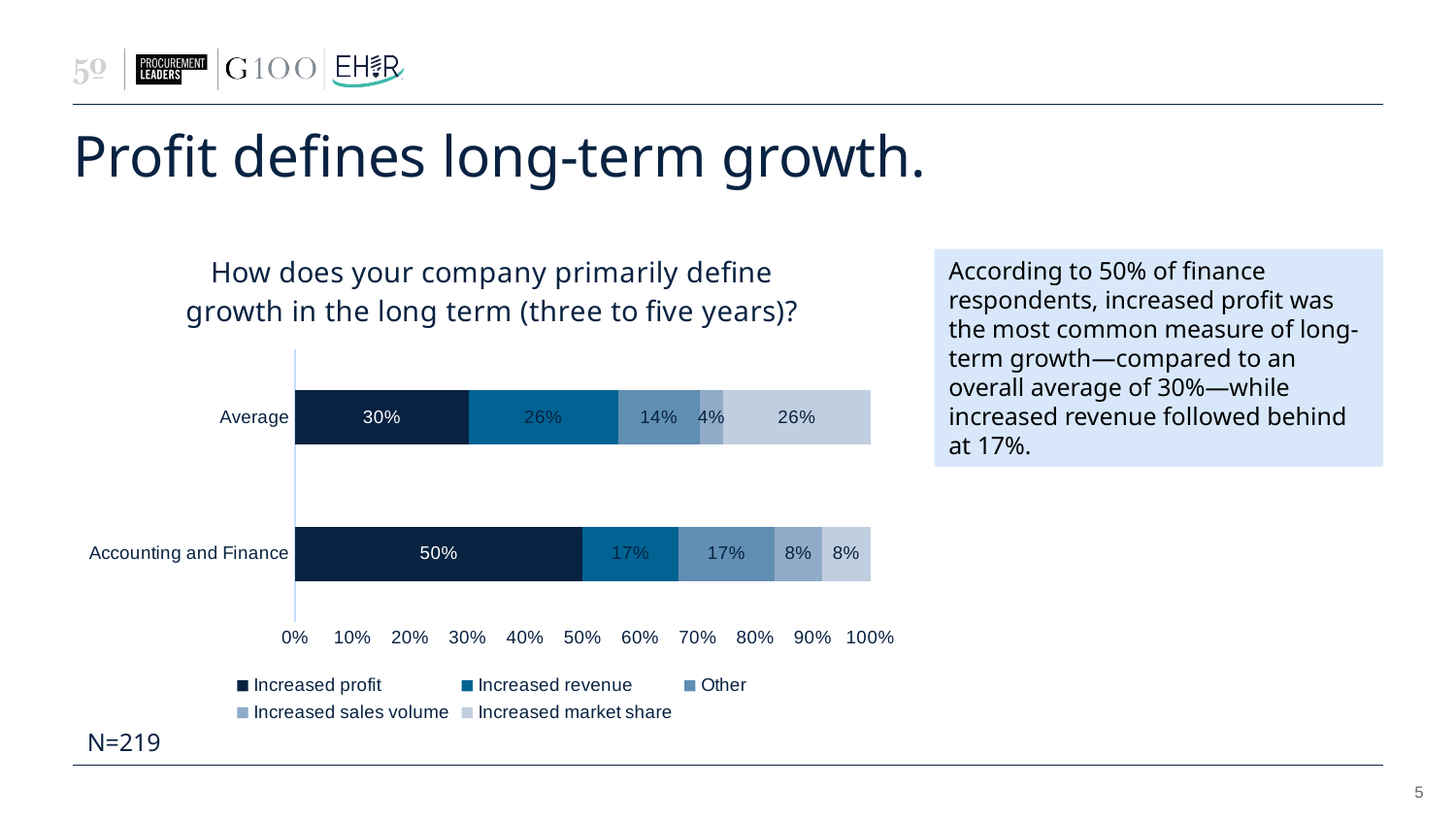
What is the difference between the Increased profit values for Accounting and Finance and Average? 20% What is the value for Increased sales volume in the Average bar? 4% Which segment is the smallest in the Average bar? Increased sales volume What is the value for Increased market share in the Accounting and Finance bar? 8% How many series does the legend list? 5 What is the value for Increased revenue in the Average bar? 26% What is the value for Increased profit in the Accounting and Finance bar? 50% How many categories (bars) are plotted in the chart? 2 What is the title of the chart? How does your company primarily define growth in the long term (three to five years)? What kind of chart is shown on the slide? Stacked bar chart What is the value for Increased profit in the Average bar? 30% Which is larger: Increased revenue for Average or Increased revenue for Accounting and Finance? Average